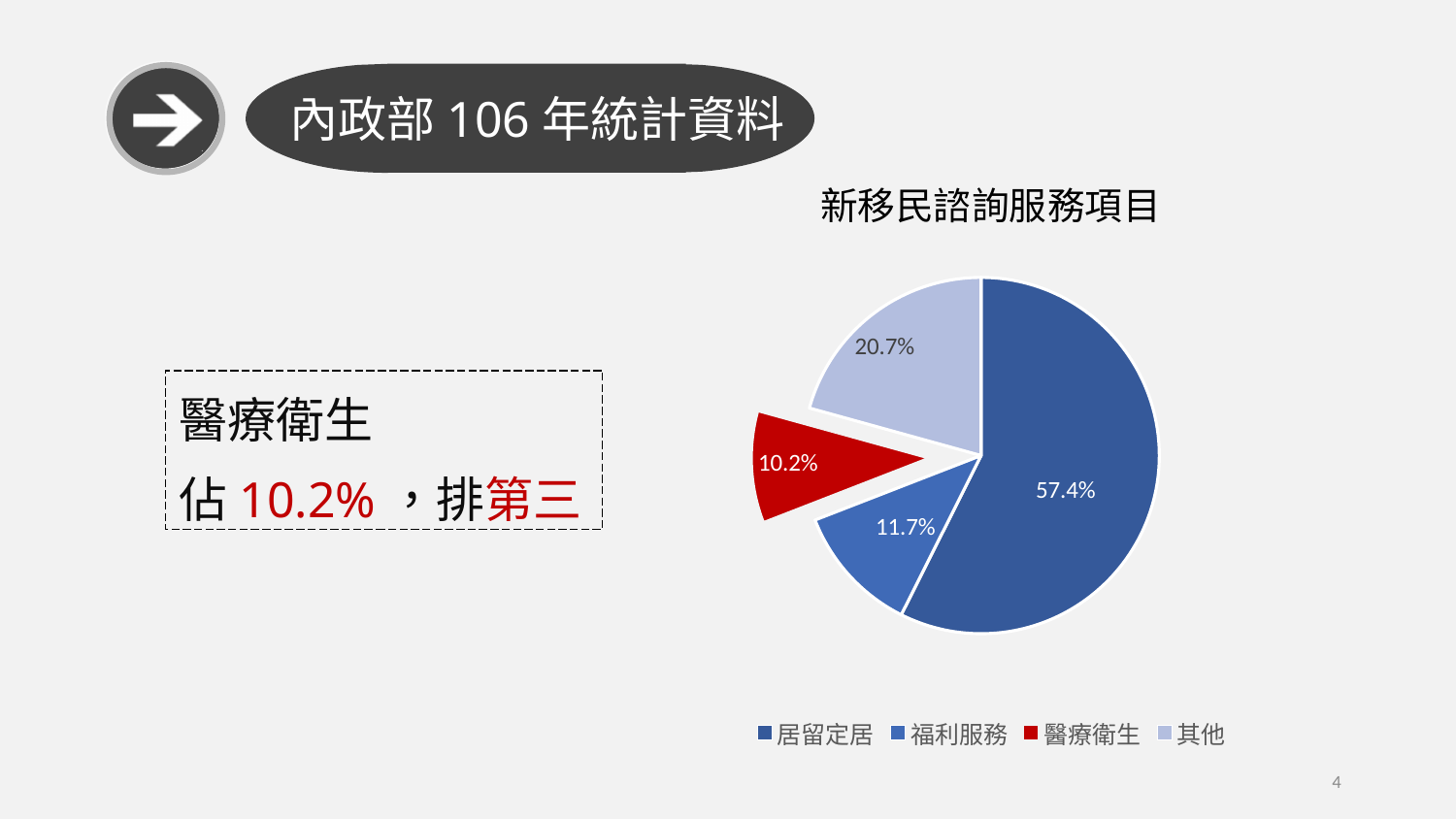
What share of the pie does 醫療衛生 take? 10.2% What is the difference in percentage points between 居留定居 and 其他? 36.7 How many categories does the pie chart show? 4 What share of the pie does 其他 take? 20.7% Which category has the largest slice of the pie? 居留定居 Which category has the smallest slice of the pie? 醫療衛生 What share of the pie does 福利服務 take? 11.7% What is the title of the pie chart? 新移民諮詢服務項目 Which slice of the pie is coloured red? 醫療衛生 Which is larger, the share for 福利服務 or the share for 其他? 其他 What kind of chart is shown on the slide? pie chart